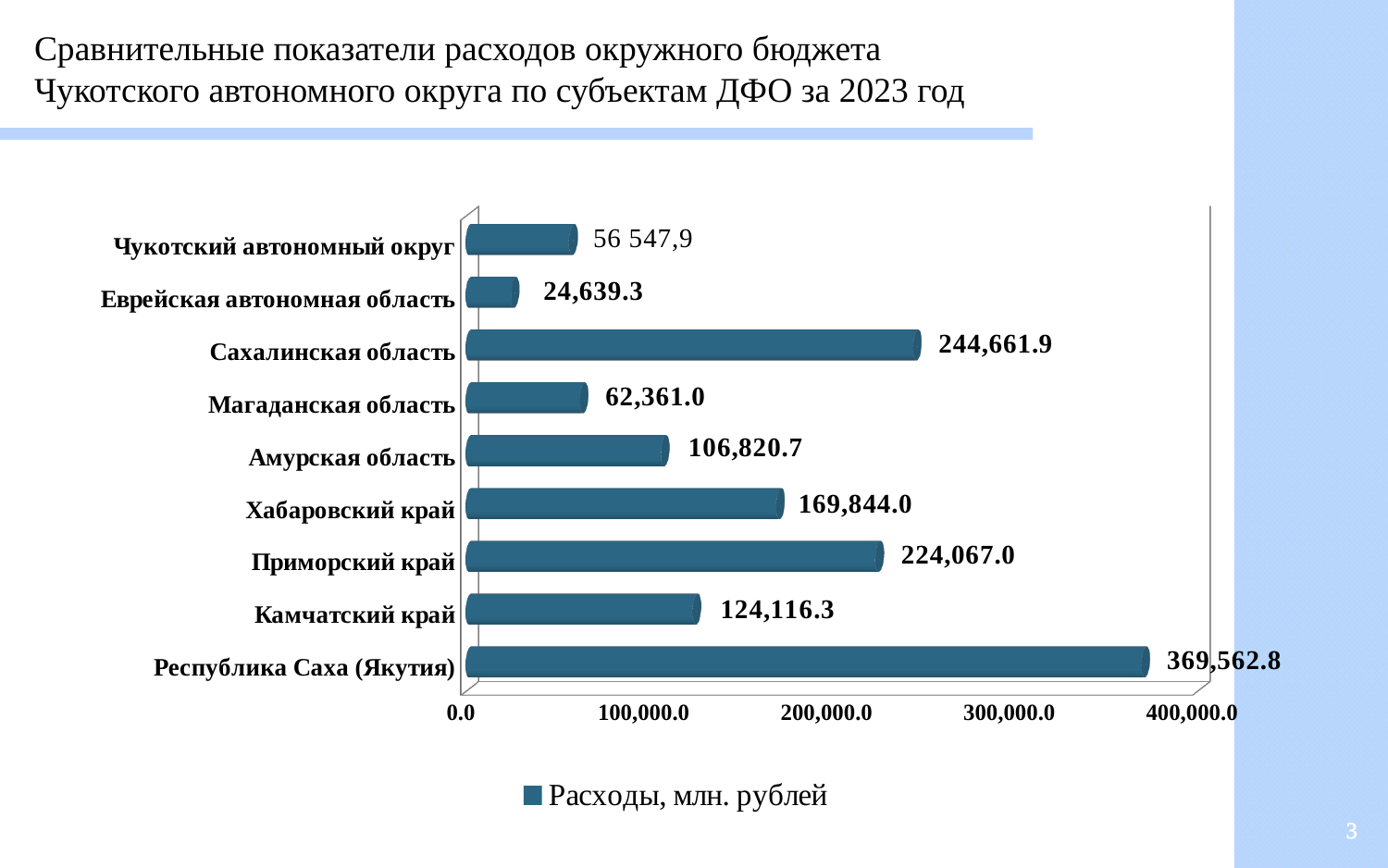
What is the value for Чукотский автономный округ? 56 547,9 Which is larger, the value for Камчатский край or the value for Магаданская область? Камчатский край How many regions are shown in the chart? 9 Which region has the lowest value? Еврейская автономная область What kind of chart is shown on the slide? bar chart Which region has the highest value? Республика Саха (Якутия) Is the value for Приморский край greater or less than 200,000.0? greater What is the value for Республика Саха (Якутия)? 369,562.8 What is the difference between the values for Сахалинская область and Приморский край? 20,594.9 What is the value for Сахалинская область? 244,661.9 How many series does the legend list? 1 What is the difference between the values for Хабаровский край and Амурская область? 63,023.3